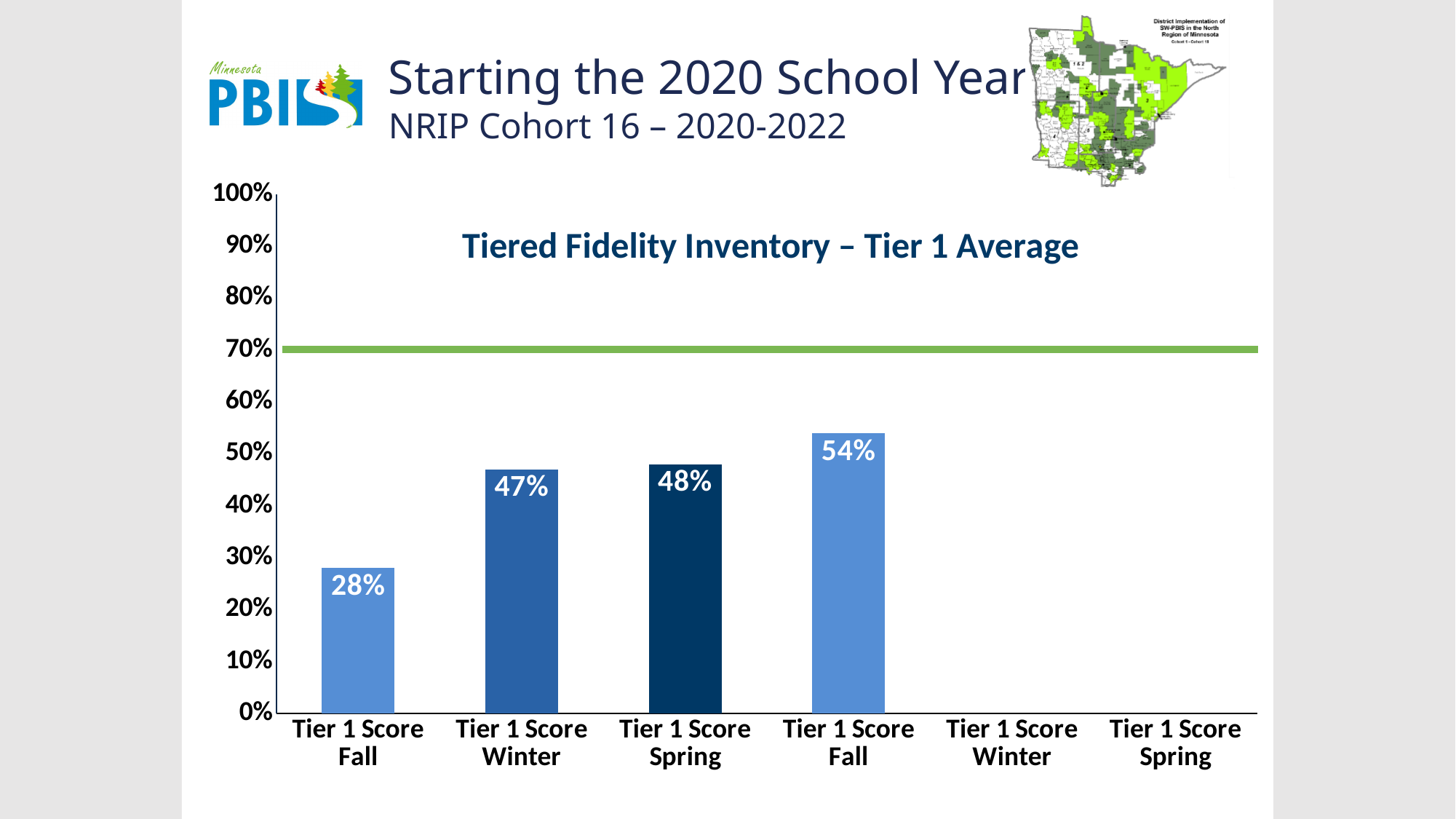
What is the value of the second Tier 1 Score Fall bar (the fourth bar)? 54% What is the value of the Tier 1 Score Spring bar? 48% Is the value of the second Tier 1 Score Fall bar greater or less than 70%? less Which bar has the lowest value? The first Tier 1 Score Fall bar (28%) Which bar has the highest value? The second Tier 1 Score Fall bar (54%) What is the value of the Tier 1 Score Winter bar? 47% What is the value of the first Tier 1 Score Fall bar? 28% How many bars with values are plotted on the chart? 4 What is the difference between the highest bar (54%) and the lowest bar (28%)? 26 percentage points Which is larger, the first Tier 1 Score Fall bar or the Tier 1 Score Winter bar? Tier 1 Score Winter (47%) What is the title of the chart? Tiered Fidelity Inventory – Tier 1 Average What kind of chart is shown on the slide? Bar chart